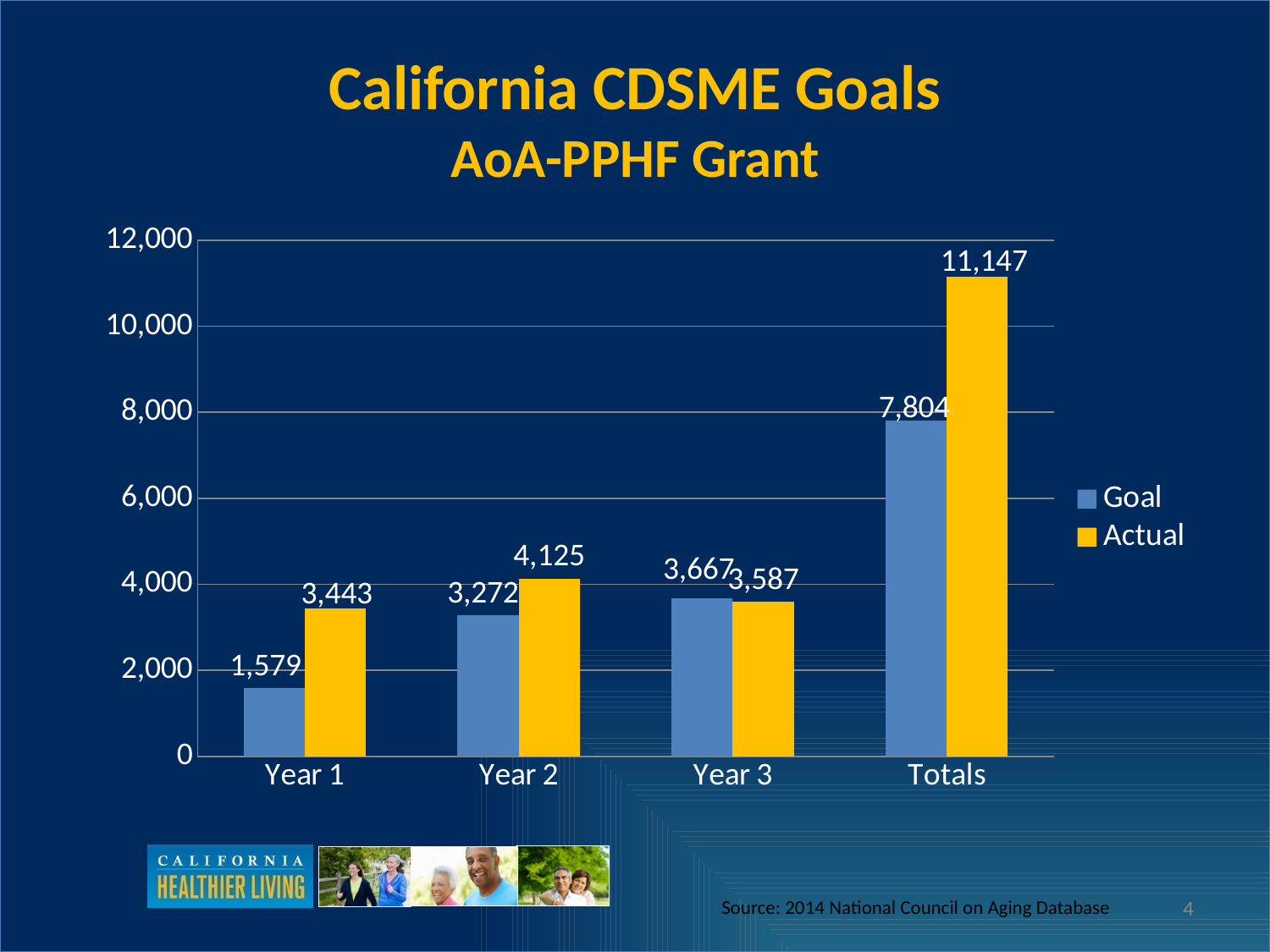
What is the difference between the Actual and Goal values for Totals? 3,343 Is the Goal value for Totals greater or less than 8,000? less What is the Goal value for Year 1? 1,579 How many categories are shown on the x axis? 4 What is the Actual value for Totals? 11,147 Is the Actual value for Year 2 larger than the Goal value for Year 2? Yes What is the difference between the Actual and Goal values for Year 1? 1,864 Which category has the lowest Goal value? Year 1 What is the Goal value for Year 3? 3,667 Which category has the highest Actual value? Totals What is the Actual value for Year 2? 4,125 How many series does the legend list? 2